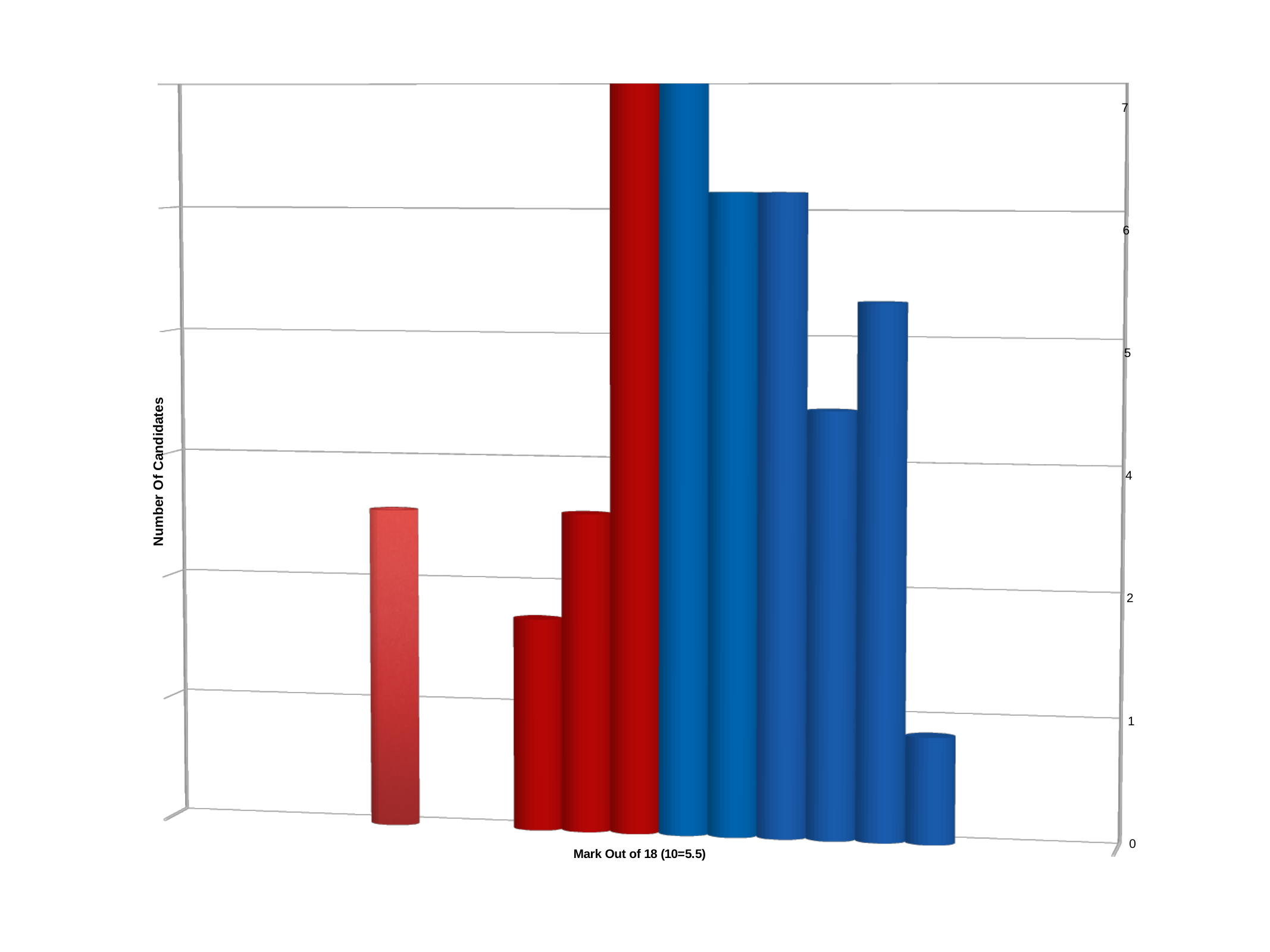
What is the title of the horizontal axis? Mark Out of 18 (10=5.5) How many red bars are plotted on the chart? 4 Which is larger, the second red bar from the left or the third red bar from the left? the third red bar from the left How many bars are plotted on the chart? 10 What is the highest value labelled on the vertical axis? 7 What is the title of the vertical axis? Number Of Candidates Which is larger, the leftmost red bar or the rightmost blue bar? the leftmost red bar Is the value of the leftmost red bar greater or less than 4? less How many blue bars are plotted on the chart? 6 Is the value of the rightmost blue bar greater or less than 2? less Is the value of the leftmost red bar greater or less than 2? greater What kind of chart is shown on the slide? bar chart